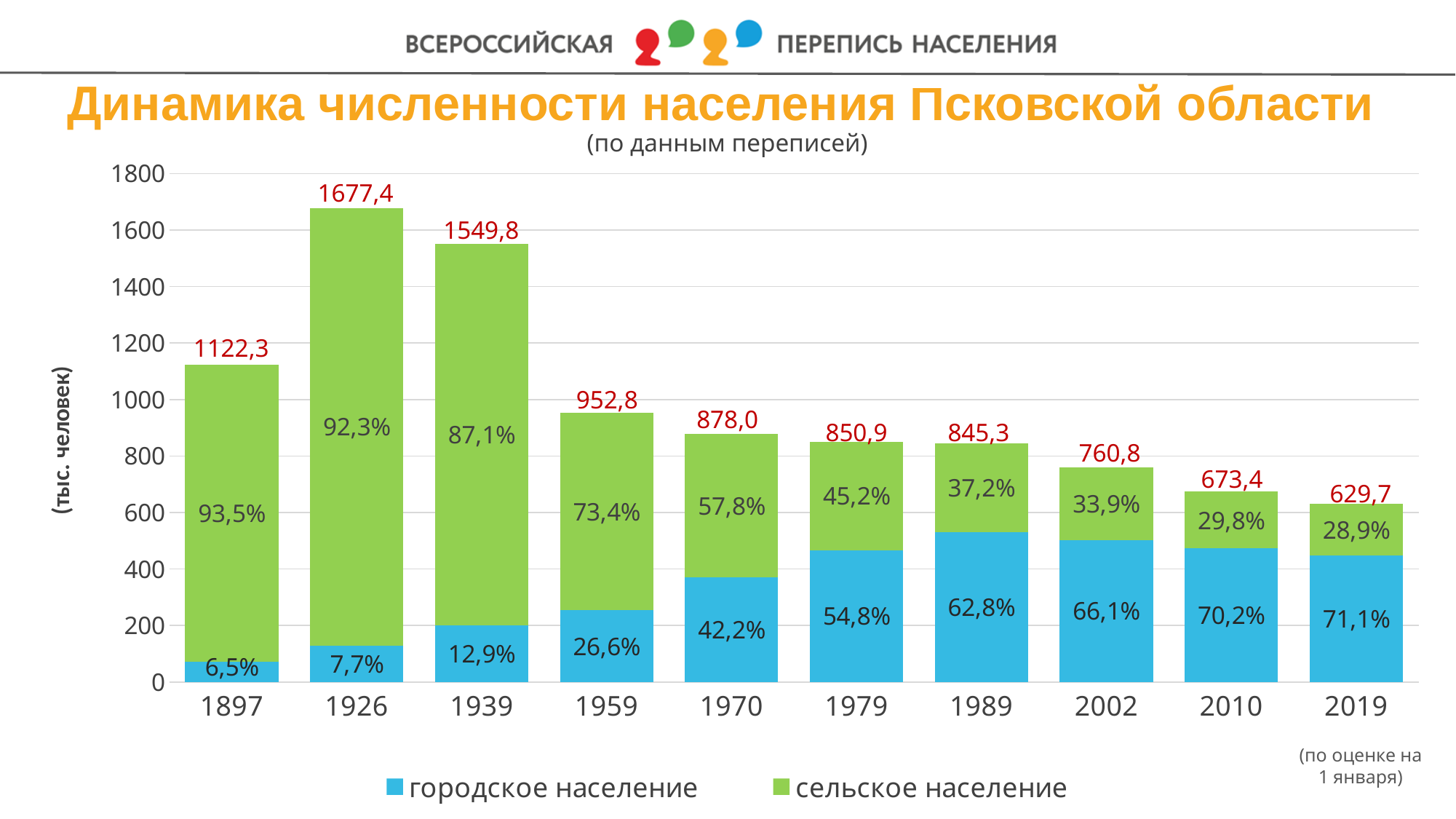
Which year has the lowest total population value? 2019 What kind of chart is shown on the slide? Stacked bar chart What percentage is shown for сельское население (rural population) in 2019? 28,9% What are the two legend entries of the chart? городское население, сельское население What is the total population value printed above the bar for 1926? 1677,4 Which year has the highest total population value? 1926 Which year has the larger total population value, 1979 or 1989? 1979 How many years (bars) are shown on the x axis? 10 What is the difference between the total population values for 1926 and 1939? 127,6 How many series does the legend list? 2 From 1926 to 2019, do the total population values rise or fall along the x axis? Fall What percentage is shown for городское население (urban population) in 1970? 42,2%